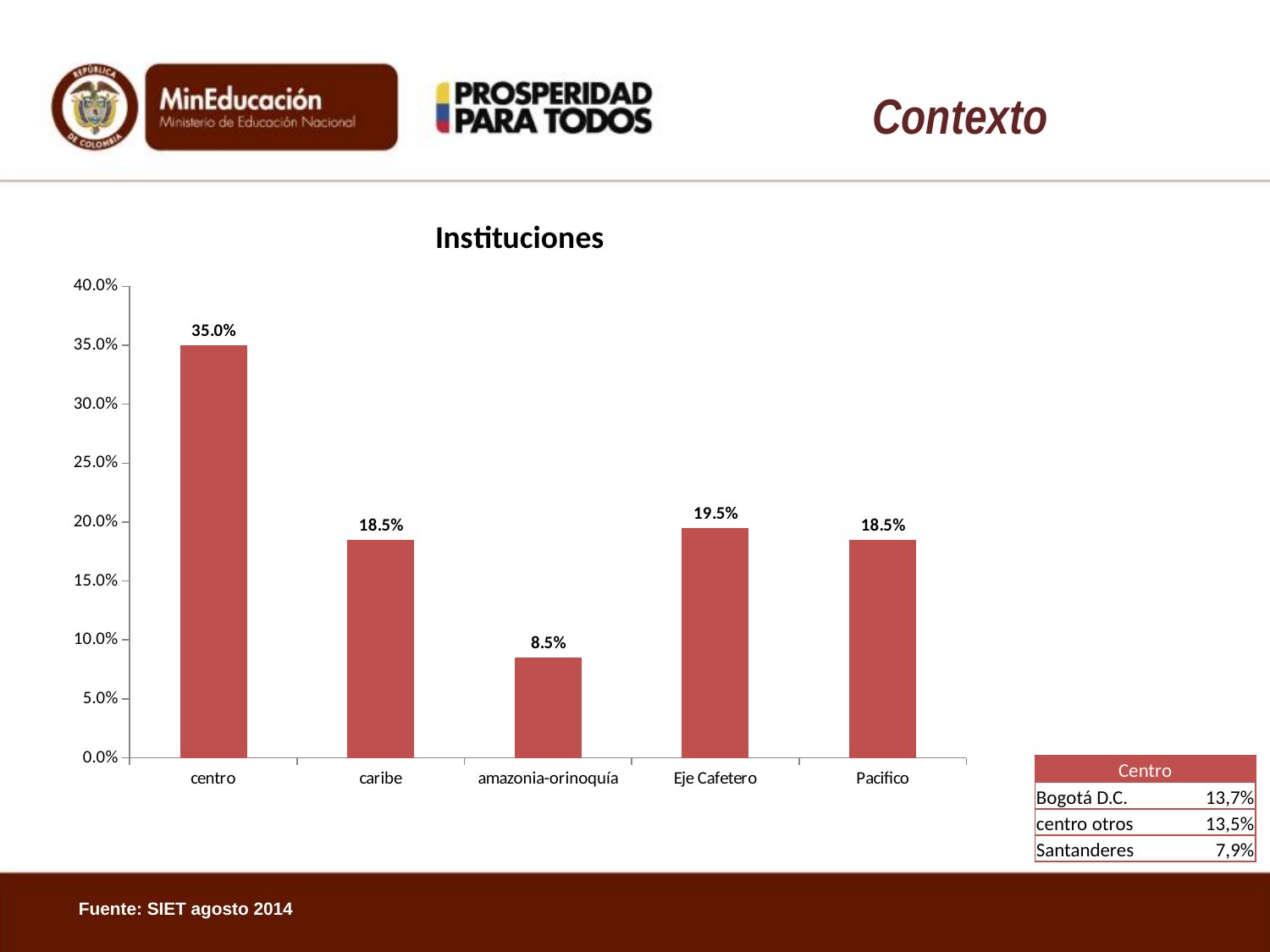
Which category has the highest value in the Instituciones chart? centro Which category has the lowest value in the Instituciones chart? amazonia-orinoquía What is the difference between the values for centro and caribe in the Instituciones chart? 16.5% What is the value for amazonia-orinoquía in the Instituciones chart? 8.5% What kind of chart is the Instituciones chart? bar chart What is the difference between the values for Eje Cafetero and amazonia-orinoquía in the Instituciones chart? 11.0% How many categories are shown in the Instituciones chart? 5 Which is larger in the Instituciones chart, the value for Eje Cafetero or the value for amazonia-orinoquía? Eje Cafetero Is the value for centro in the Instituciones chart greater or less than 30.0%? greater What is the title of the chart on the slide? Instituciones What is the value for Eje Cafetero in the Instituciones chart? 19.5% What is the value for centro in the Instituciones chart? 35.0%